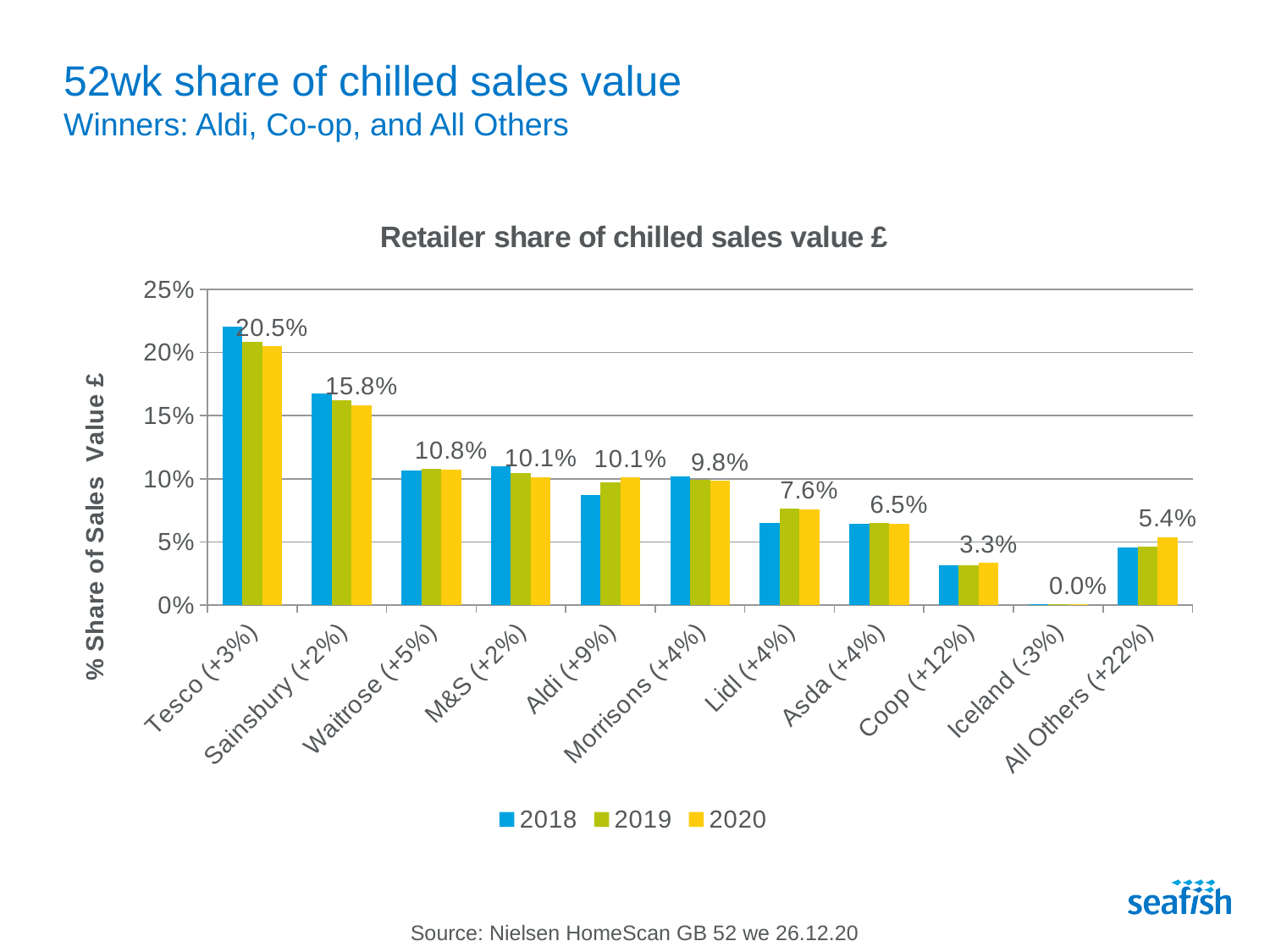
What kind of chart is shown on the slide? bar chart How many retailer categories are shown on the x axis? 11 What value is labelled for All Others (+22%)? 5.4% What value is labelled for Tesco (+3%)? 20.5% What value is labelled for Lidl (+4%)? 7.6% Do the bars for Tesco (+3%) rise or fall from 2018 to 2020? fall How many series does the legend list? 3 Is the 2018 value for Tesco (+3%) greater or less than 20%? greater What is the title of the chart? Retailer share of chilled sales value £ Which retailer has the highest labelled share of chilled sales value? Tesco (+3%) Which retailer has the lowest labelled share of chilled sales value? Iceland (-3%) What is the difference between the labelled values for Tesco (+3%) and Sainsbury (+2%)? 4.7%